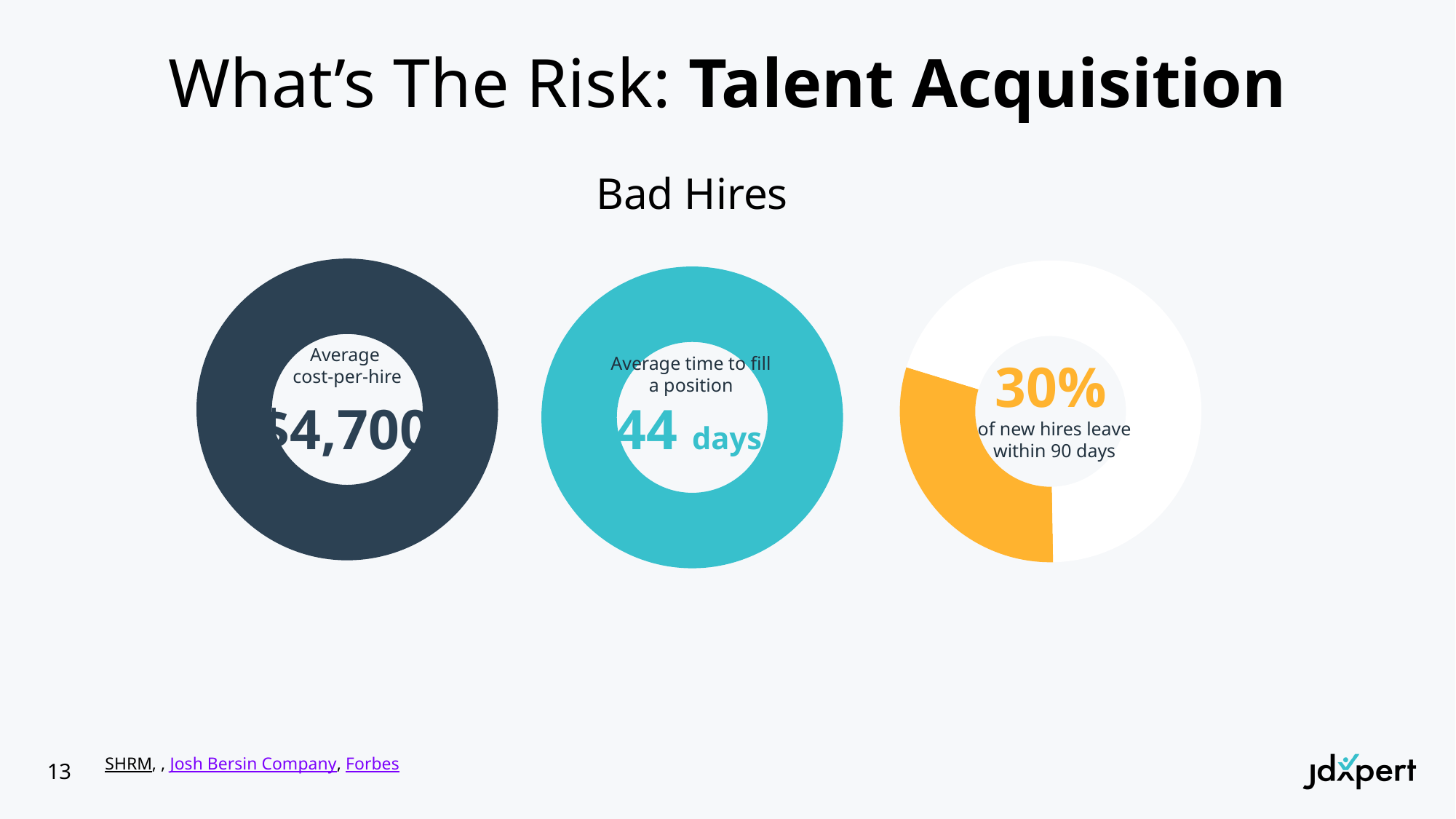
On the right-hand donut chart, what share of the ring is not filled in orange? 70% What value is printed in the centre of the middle teal ring for average time to fill a position? 44 days On the right-hand donut chart, what colour is the filled 30% segment? Orange How many circular ring graphics are shown on the slide? 3 What is the subtitle above the three ring graphics? Bad Hires On the right-hand donut chart, is the filled segment greater or less than 50% of the ring? less What value is printed in the centre of the left-hand dark blue ring for average cost-per-hire? $4,700 On the right-hand donut chart, what percentage of new hires leave within 90 days? 30% What kind of chart is the right-hand graphic showing the share of new hires who leave within 90 days? Donut chart